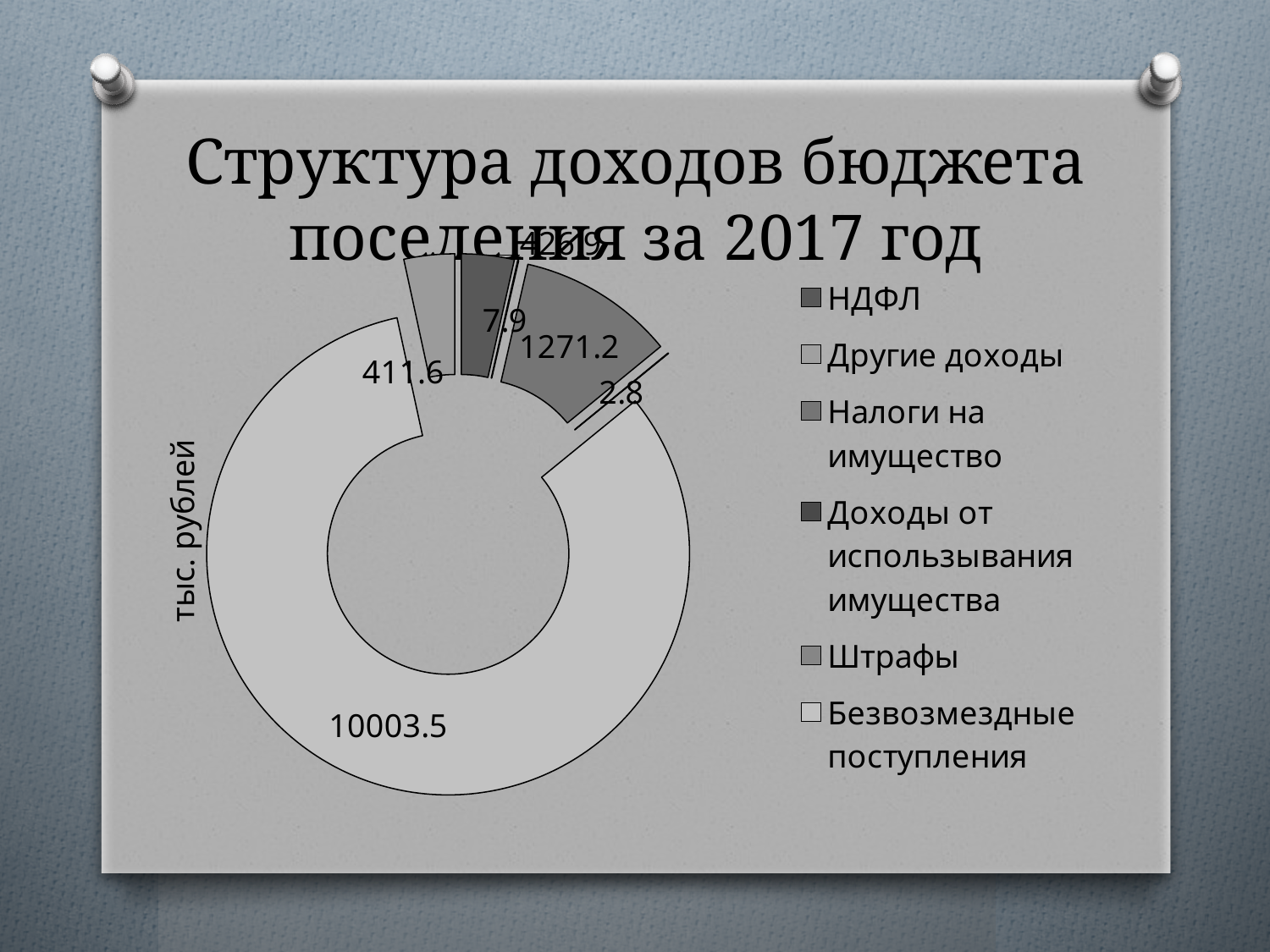
What is the difference between the slice labelled 7.9 and the slice labelled 2.8? 5.1 In what units are the chart values given, according to the label beside the chart? тыс. рублей What is the title of the slide's chart? Структура доходов бюджета поселения за 2017 год What kind of chart is shown on the slide? doughnut (pie) chart What is the smallest clearly readable value labelled on the chart? 2.8 How many categories does the legend of the chart list? 6 What is the difference between the slice labelled 1271.2 and the slice labelled 411.6? 859.6 What is the difference between the slice labelled 10003.5 and the slice labelled 1271.2? 8732.3 Which is larger, the slice labelled 1271.2 or the slice labelled 411.6? 1271.2 Does the largest slice of the doughnut account for more or less than half of the whole? more What is the largest value labelled on the chart? 10003.5